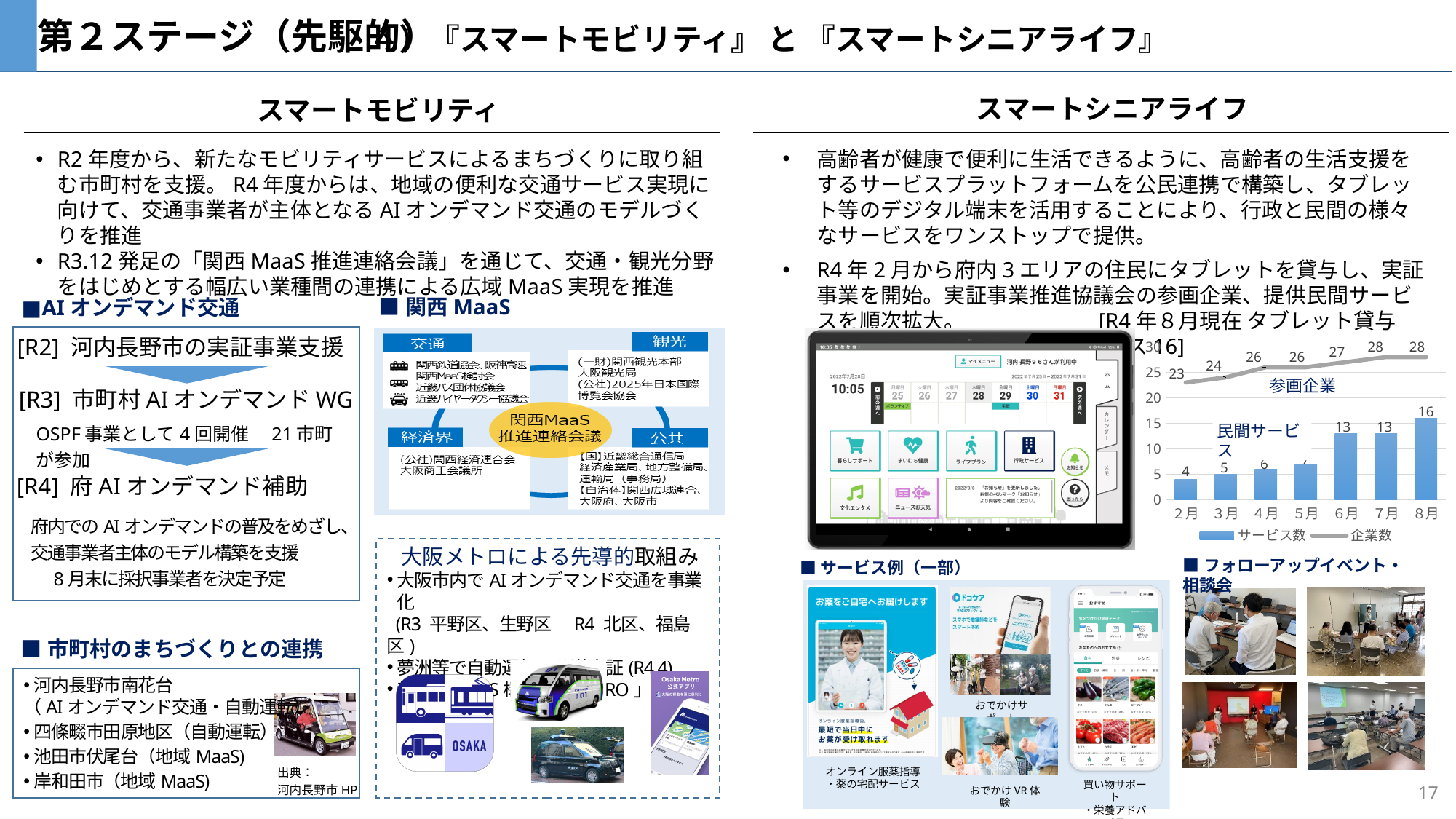
In the chart on the right, which month has the highest サービス数? 8月 Does the 企業数 line in the chart on the right rise or fall from 2月 to 8月? rises In the chart on the right, what is the サービス数 value for 8月? 16 How many series does the legend of the chart on the right list? 2 In the chart on the right, what is the difference in 企業数 between 8月 and 2月? 5 In the chart on the right, which month has a larger サービス数, 6月 or 3月? 6月 In the chart on the right, what is the 企業数 value for 2月? 23 In the chart on the right, which month has the lowest サービス数? 2月 In the chart on the right, what is the 企業数 value for 8月? 28 In the chart on the right, is the サービス数 value for 5月 greater or less than 10? less How many months are shown on the x axis of the chart on the right? 7 In the chart on the right, what is the difference in サービス数 between 8月 and 2月? 12